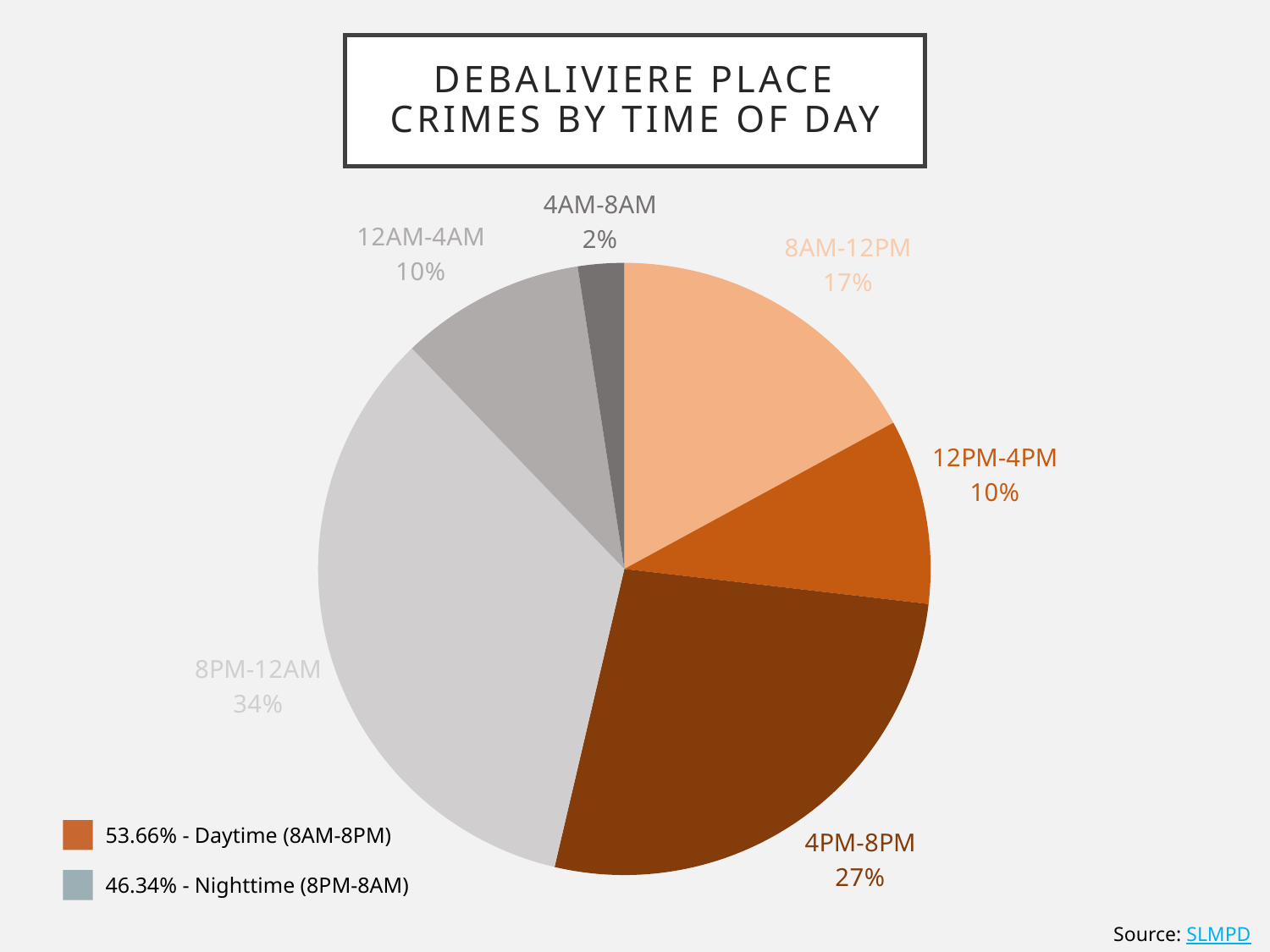
What is the title of the chart? DeBaliviere Place Crimes by Time of Day Which time-of-day slice is the smallest? 4AM-8AM According to the legend, what percentage of crimes occurred during the daytime (8AM-8PM)? 53.66% What is the difference in percentage points between the 8PM-12AM slice and the 4PM-8PM slice? 7 What share of crimes occurred between 4PM and 8PM? 27% What share of crimes occurred between 4AM and 8AM? 2% What share of crimes occurred between 8PM and 12AM? 34% Which slice is larger, 8AM-12PM or 12PM-4PM? 8AM-12PM What kind of chart is shown on the slide? Pie chart Which time-of-day slice is the largest? 8PM-12AM How many time-of-day slices does the pie chart have? 6